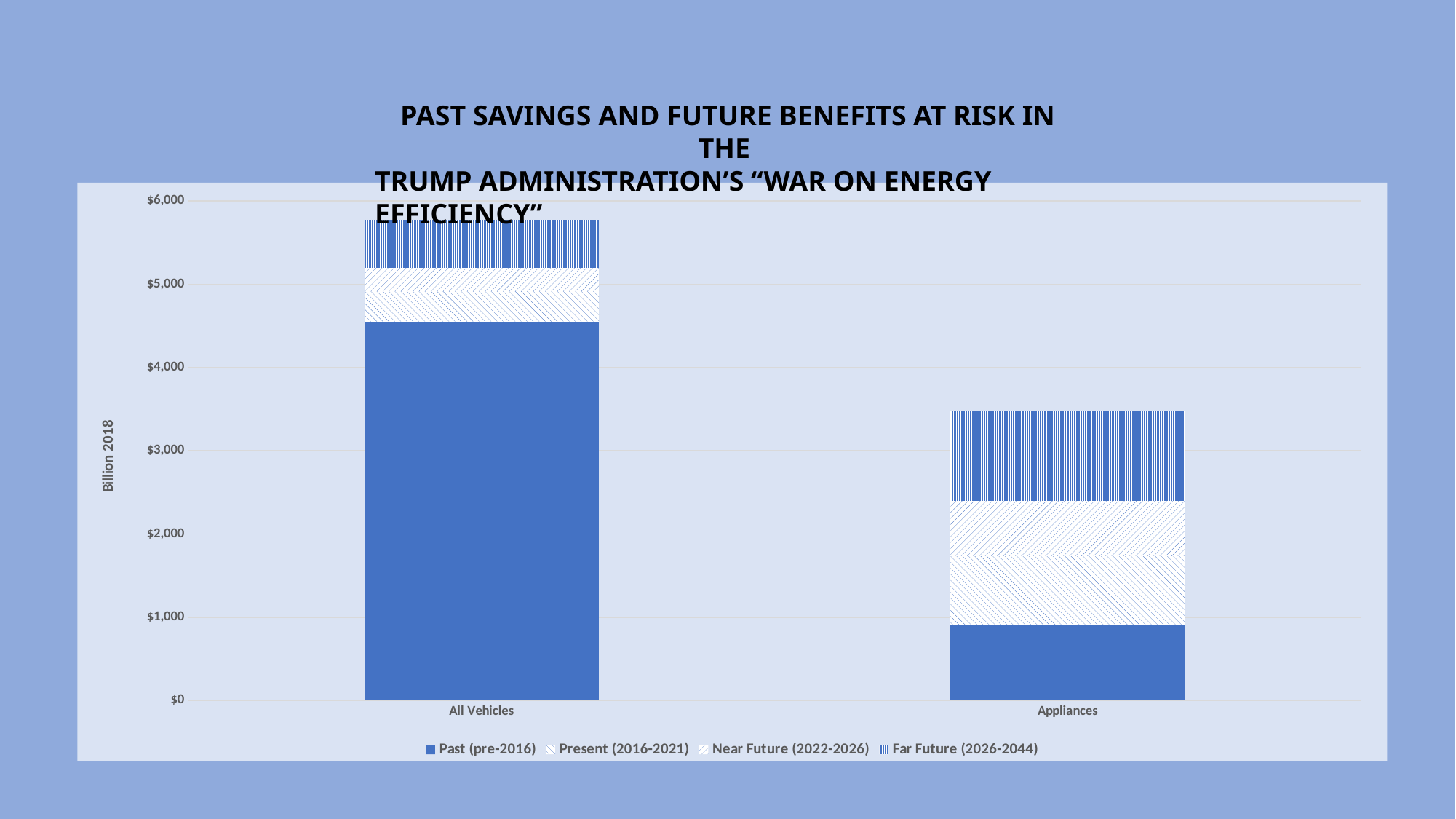
What is the label on the vertical axis? Billion 2018 Which legend entry covers the years 2026-2044? Far Future (2026-2044) How many categories are shown on the x axis? 2 What kind of chart is shown on the slide? Stacked bar chart Is the Past (pre-2016) value for Appliances greater or less than $1,000? less Which category has the larger Past (pre-2016) segment, All Vehicles or Appliances? All Vehicles Is the total stacked value for All Vehicles greater or less than $5,000? greater Is the total stacked value for Appliances greater or less than $4,000? less Which category has the taller stacked bar overall? All Vehicles How many series does the legend list? 4 Which category has the shorter stacked bar overall? Appliances